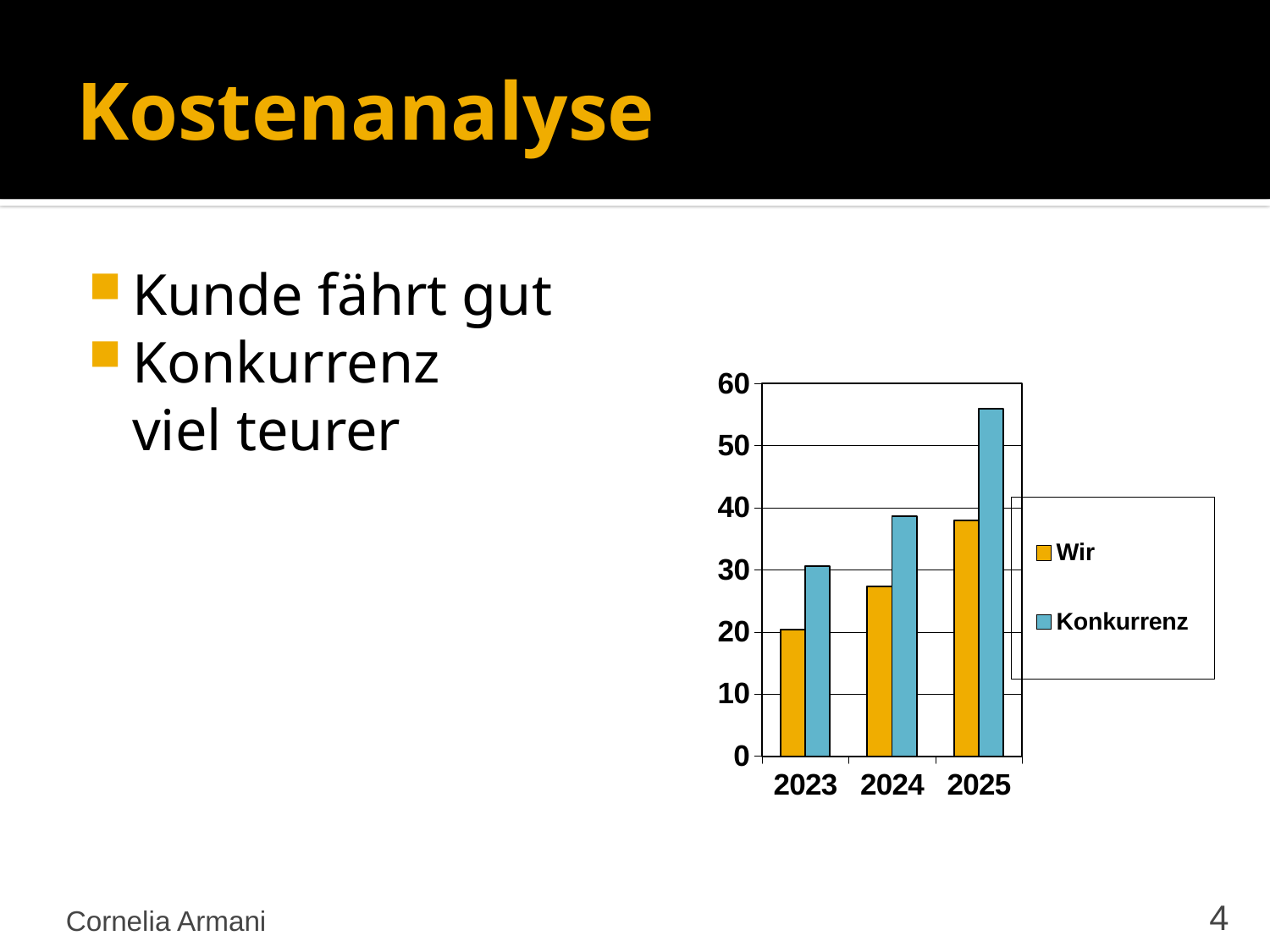
In 2024, which series has the larger value, Wir or Konkurrenz? Konkurrenz How many series does the chart's legend list? 2 Which series and year has the highest bar in the chart? Konkurrenz in 2025 Is the value for Konkurrenz in 2025 greater or less than 50? greater Which series and year has the lowest bar in the chart? Wir in 2023 How many years are shown on the x axis of the chart? 3 In 2025, which series has the larger value, Wir or Konkurrenz? Konkurrenz What are the two entries listed in the chart's legend? Wir and Konkurrenz What kind of chart is shown on the slide? bar chart Is the value for Wir in 2024 greater or less than 30? less Is the value for Wir in 2023 greater or less than 30? less Do the values for Wir rise or fall from 2023 to 2025? rise